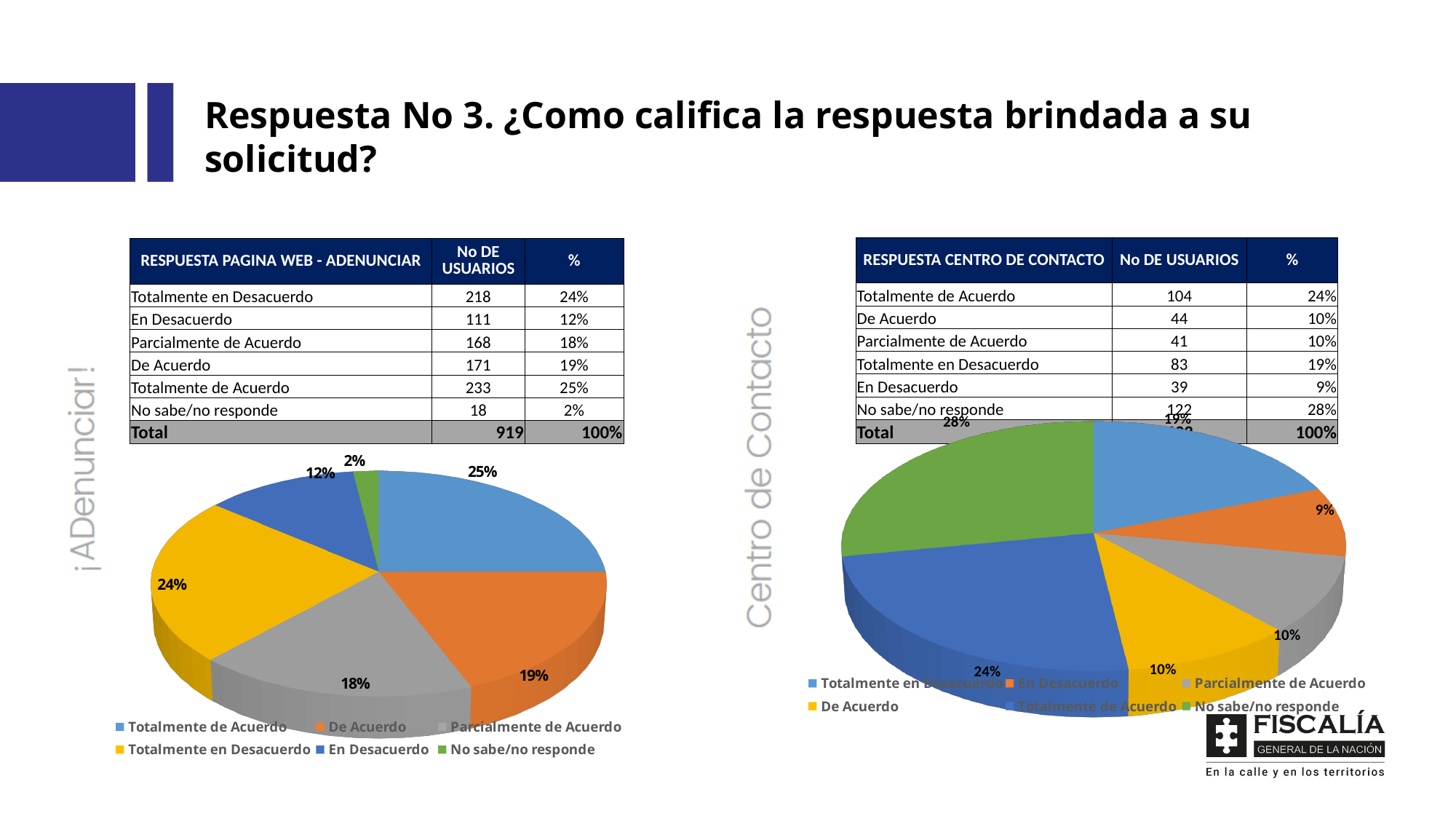
What kind of chart is shown on the left side of the slide (ADenunciar)? Pie chart In the left pie chart (ADenunciar), what percentage is shown for Totalmente de Acuerdo? 25% In the left pie chart (ADenunciar), which category has the smallest slice? No sabe/no responde In the right pie chart (Centro de Contacto), which is larger: the Totalmente de Acuerdo slice or the Totalmente en Desacuerdo slice? Totalmente de Acuerdo In the right pie chart (Centro de Contacto), what percentage is shown for No sabe/no responde? 28% In the left pie chart (ADenunciar), what percentage is shown for No sabe/no responde? 2% In the right pie chart (Centro de Contacto), what colour is the No sabe/no responde slice? Green In the left pie chart (ADenunciar), which category has the largest slice? Totalmente de Acuerdo In the left pie chart (ADenunciar), what is the difference between the Totalmente en Desacuerdo slice and the En Desacuerdo slice? 12% In the right pie chart (Centro de Contacto), which category has the largest slice? No sabe/no responde How many categories does the legend of the left pie chart (ADenunciar) list? 6 In the right pie chart (Centro de Contacto), what percentage is shown for En Desacuerdo? 9%